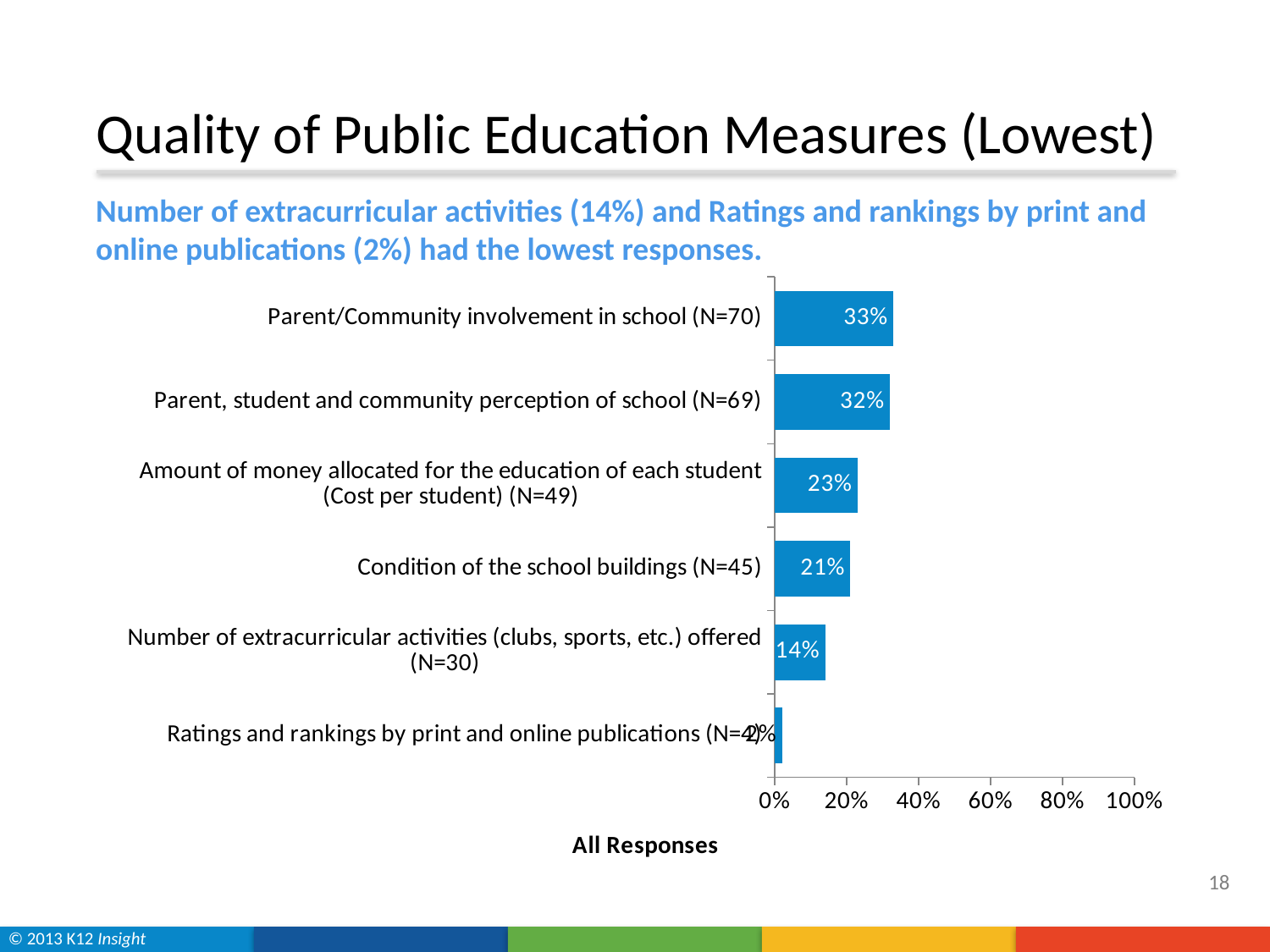
What kind of chart is shown on the slide? bar chart Which category has the lowest value? Ratings and rankings by print and online publications (N=4) What is the difference between the values for Parent/Community involvement in school (N=70) and Condition of the school buildings (N=45)? 12% Is the value for Parent, student and community perception of school (N=69) greater or less than 40%? less What is the value for Amount of money allocated for the education of each student (Cost per student) (N=49)? 23% What is the value for Parent/Community involvement in school (N=70)? 33% Which category has the highest value? Parent/Community involvement in school (N=70) Which is larger: the value for Amount of money allocated for the education of each student (Cost per student) (N=49) or the value for Number of extracurricular activities (clubs, sports, etc.) offered (N=30)? Amount of money allocated for the education of each student (Cost per student) (N=49) What is the label shown below the horizontal axis of the chart? All Responses What is the value for Condition of the school buildings (N=45)? 21% How many categories are shown in the chart? 6 What is the value for Number of extracurricular activities (clubs, sports, etc.) offered (N=30)? 14%